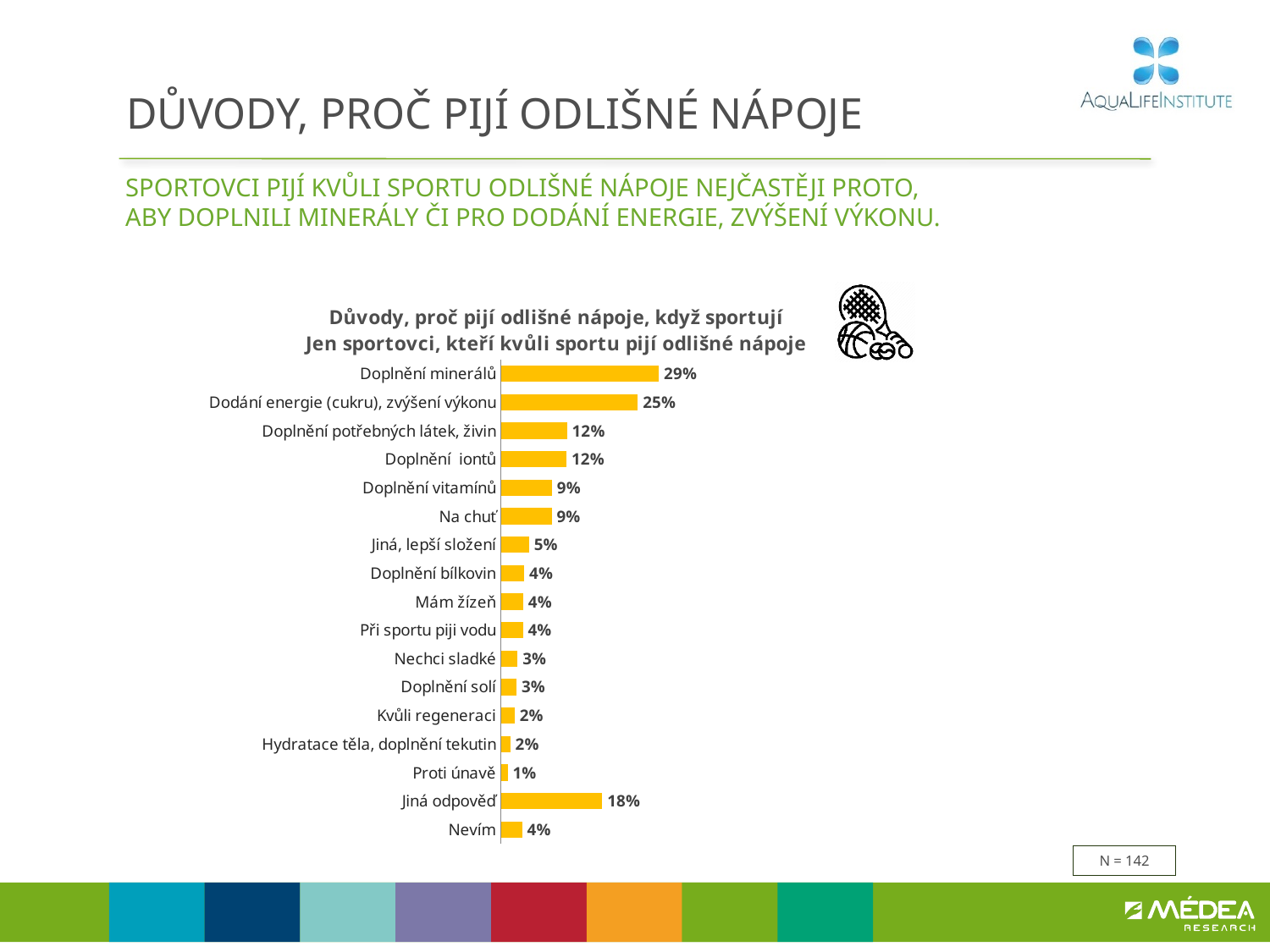
What sample size (N) is shown on the slide? N = 142 What kind of chart is this? Bar chart What is the value for Dodání energie (cukru), zvýšení výkonu? 25% What is the value for Jiná odpověď? 18% Which is larger, Jiná odpověď or Doplnění potřebných látek, živin? Jiná odpověď How many categories are shown in the chart? 17 Which category has the lowest value? Proti únavě Which category has the highest value? Doplnění minerálů What is the difference between Jiná, lepší složení and Proti únavě? 4 percentage points What is the difference between Doplnění minerálů and Dodání energie (cukru), zvýšení výkonu? 4 percentage points What is the value for Na chuť? 9% What is the value for Doplnění minerálů? 29%